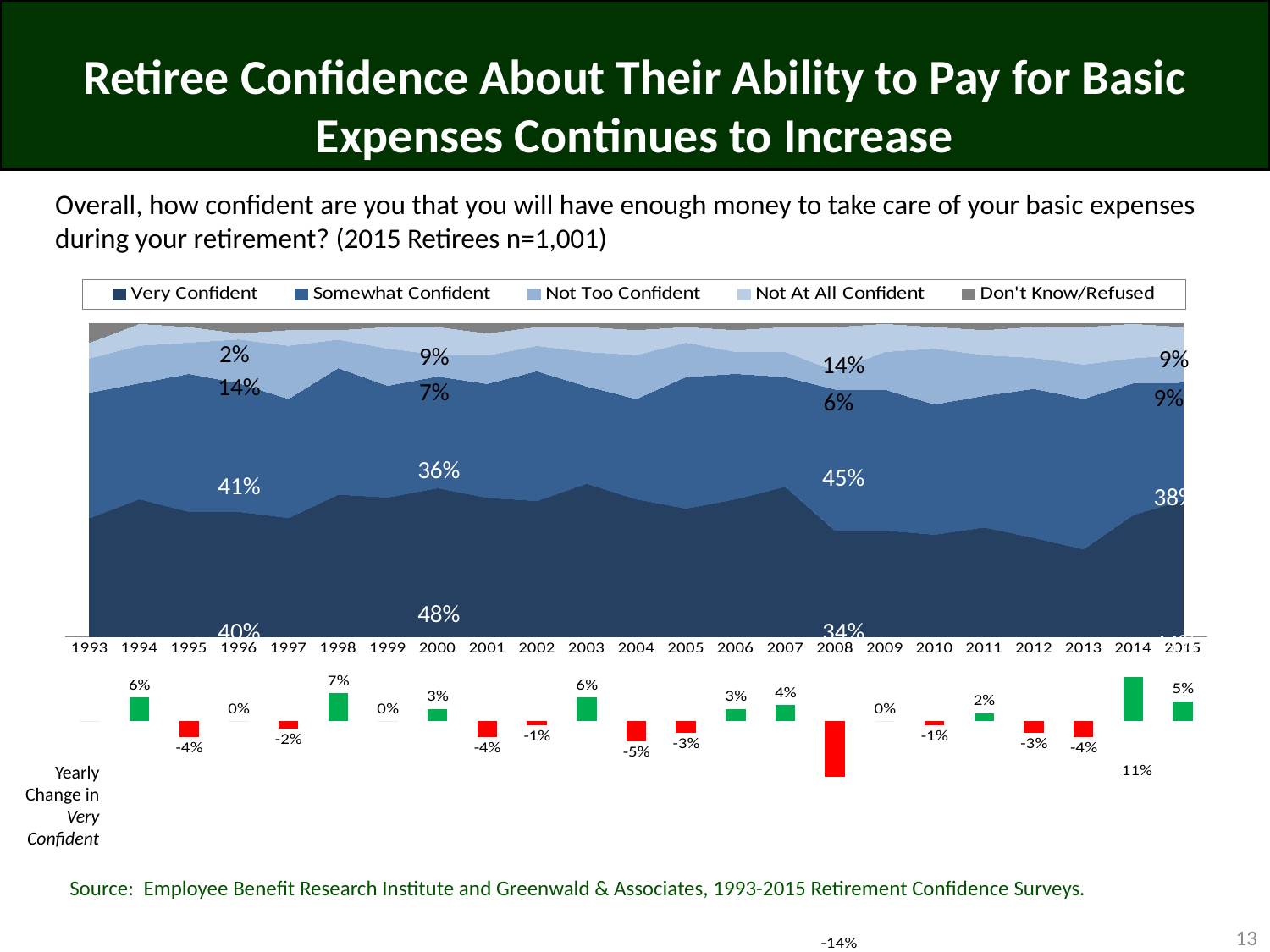
In the bottom bar chart of yearly change in Very Confident, which year has the highest value? 2014 In the top stacked area chart, what percentage of retirees were Not Too Confident in 2015? 9% In the bottom bar chart of yearly change in Very Confident, which year has the lowest value? 2008 In the bottom bar chart of yearly change in Very Confident, what is the value for 2004? -5% In the bottom bar chart of yearly change in Very Confident, what is the value for 2014? 11% In the top stacked area chart, what percentage of retirees were Somewhat Confident in 2008? 45% What kind of chart is the bottom chart showing yearly change in Very Confident? Bar chart How many series does the legend of the top stacked area chart list? 5 In the top stacked area chart, which was larger in 1996: the Very Confident share or the Somewhat Confident share? Somewhat Confident In the top stacked area chart, what percentage of retirees were Not At All Confident in 1996? 2% In the top stacked area chart, what percentage of retirees were Very Confident in 2000? 48% In the top stacked area chart, what is the difference between the Very Confident share in 2000 and in 2008? 14%